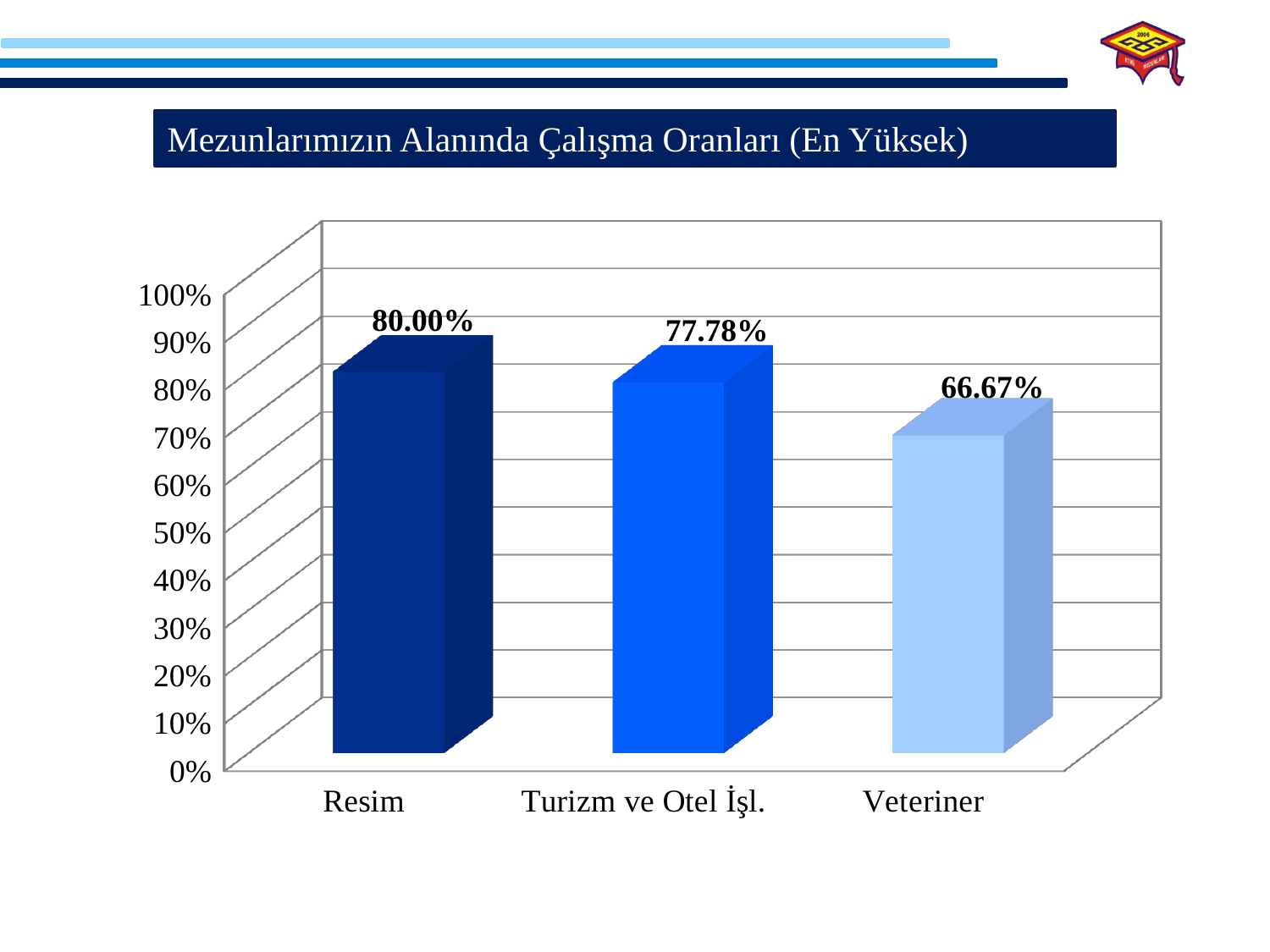
What is the difference between the values for Turizm ve Otel İşl. and Veteriner? 11.11% Which category has the lowest value? Veteriner What is the difference between the values for Resim and Veteriner? 13.33% How many categories are shown in the chart? 3 What is the title of the slide? Mezunlarımızın Alanında Çalışma Oranları (En Yüksek) What is the value for Turizm ve Otel İşl.? 77.78% Which category has the highest value? Resim What is the value for Veteriner? 66.67% What is the value for Resim? 80.00% What kind of chart is shown on the slide? bar chart Which is larger, the value for Resim or the value for Veteriner? Resim Is the value for Veteriner greater or less than 70%? less